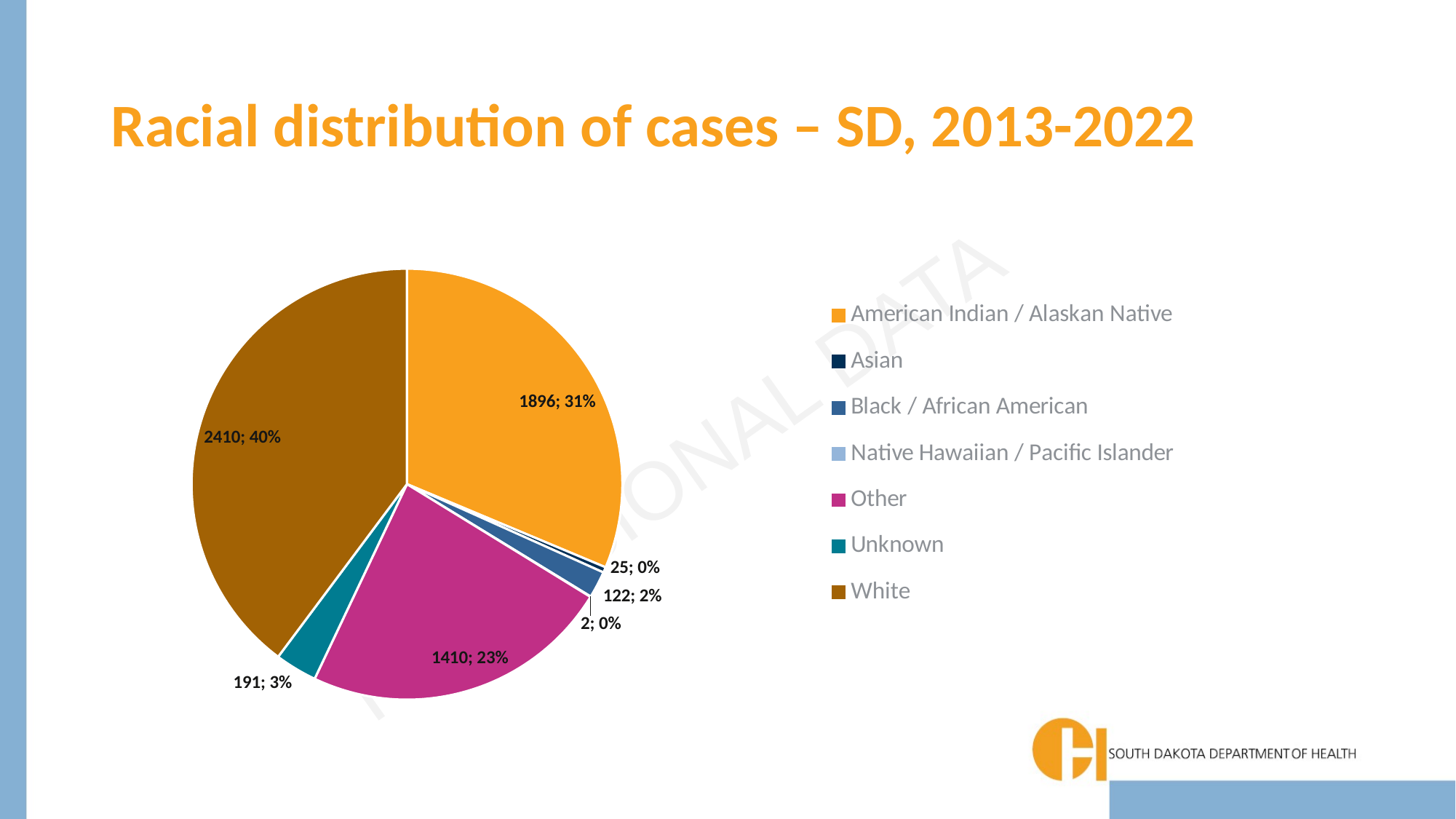
How many cases are shown for Other? 1410 Which has more cases, Other or Unknown? Other How many cases are shown for White? 2410 What type of chart is shown on the slide? pie chart How many categories does the legend list? 7 What is the difference in cases between White and American Indian / Alaskan Native? 514 What share of cases is American Indian / Alaskan Native? 31% What share of cases is Unknown? 3% Which category has the largest slice of the pie? White What is the title of the chart slide? Racial distribution of cases – SD, 2013-2022 Which category has the smallest slice of the pie? Native Hawaiian / Pacific Islander How many cases are shown for Black / African American? 122